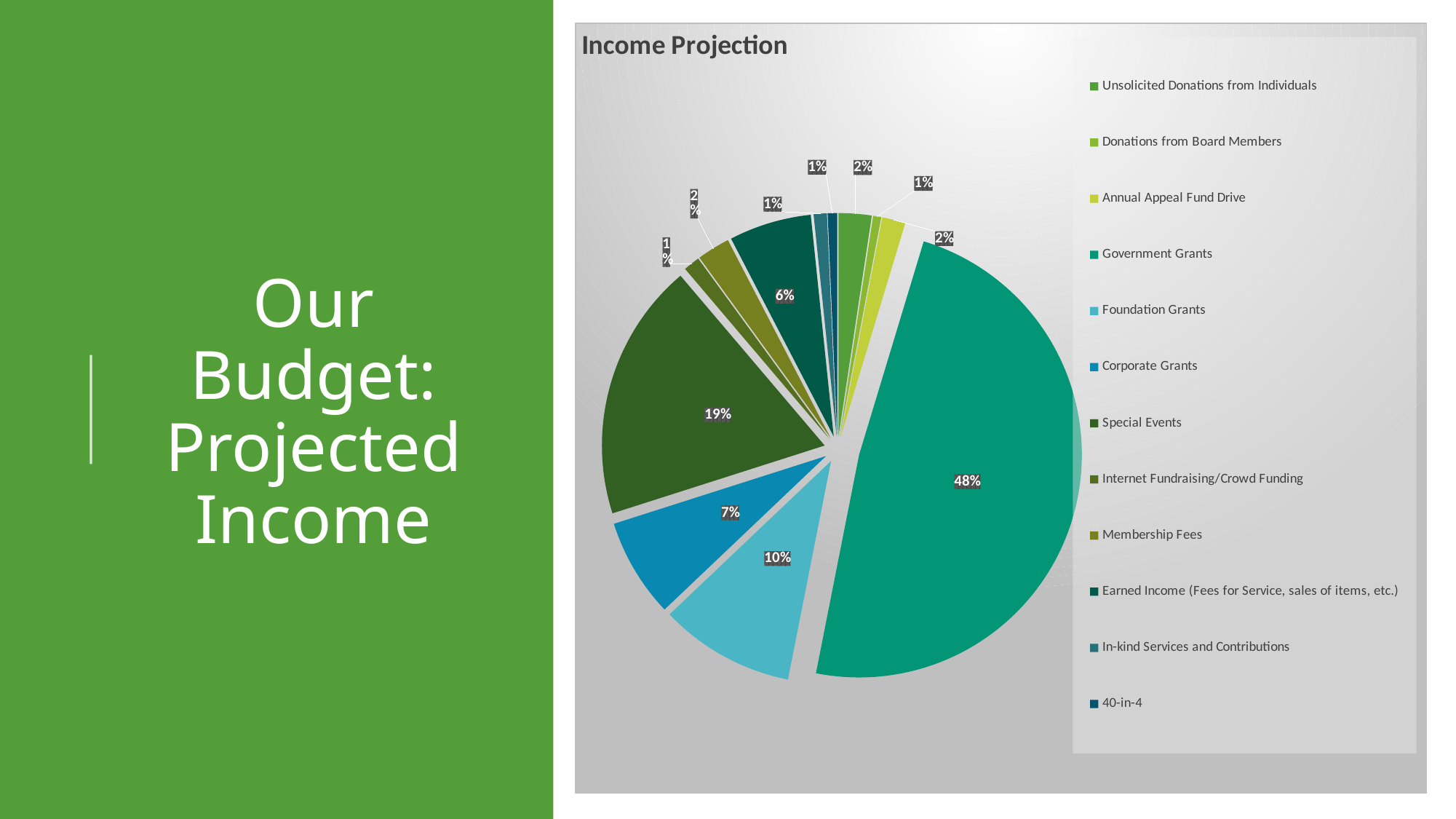
Which category has the largest share of projected income? Government Grants What share of projected income comes from Corporate Grants? 7% What share of projected income comes from Foundation Grants? 10% What share of projected income comes from Government Grants? 48% What is the difference between the Government Grants share and the Special Events share? 29% How many categories does the legend of the Income Projection chart list? 12 What share of projected income comes from Earned Income (Fees for Service, sales of items, etc.)? 6% What is the combined share of Foundation Grants and Corporate Grants? 17% Which is larger, the share for Foundation Grants or the share for Corporate Grants? Foundation Grants What type of chart is shown on the slide? pie chart What share of projected income comes from Special Events? 19% What is the title of the chart? Income Projection